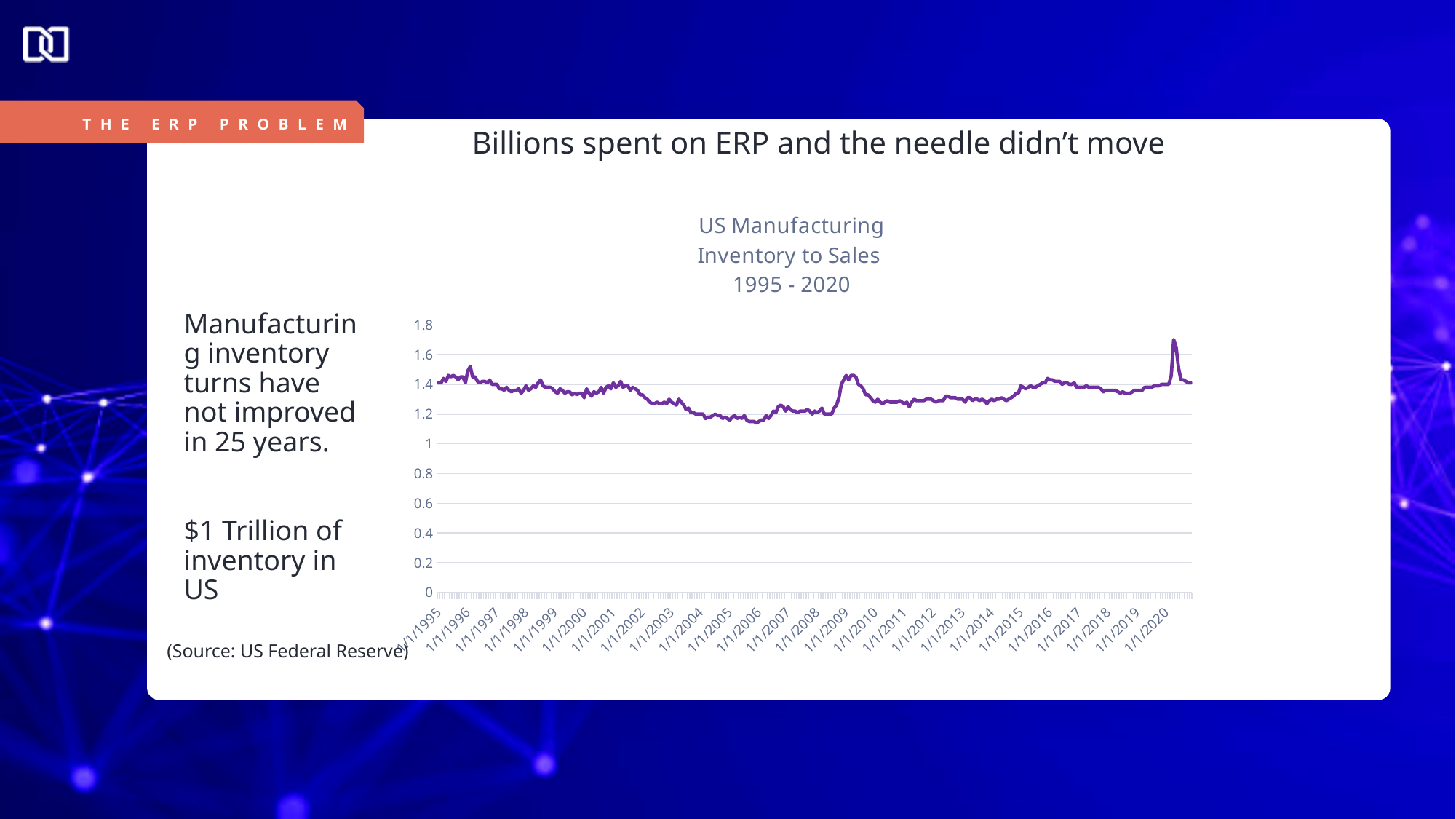
How many year labels are shown along the x axis of the chart? 26 Does the line rise or fall between 1/1/2001 and 1/1/2005? fall Is the value of the line at 1/1/2012 greater or less than 1.0? greater Is the value of the line at 1/1/2016 greater or less than 1.2? greater Is the value of the line at 1/1/2005 greater or less than 1.4? less What is the title of the chart? US Manufacturing Inventory to Sales 1995 - 2020 What kind of chart is shown on the slide? line chart Around which year does the line reach its lowest point? 2006 What is the highest value shown on the vertical axis of the chart? 1.8 Around which year does the line reach its highest point? 2020